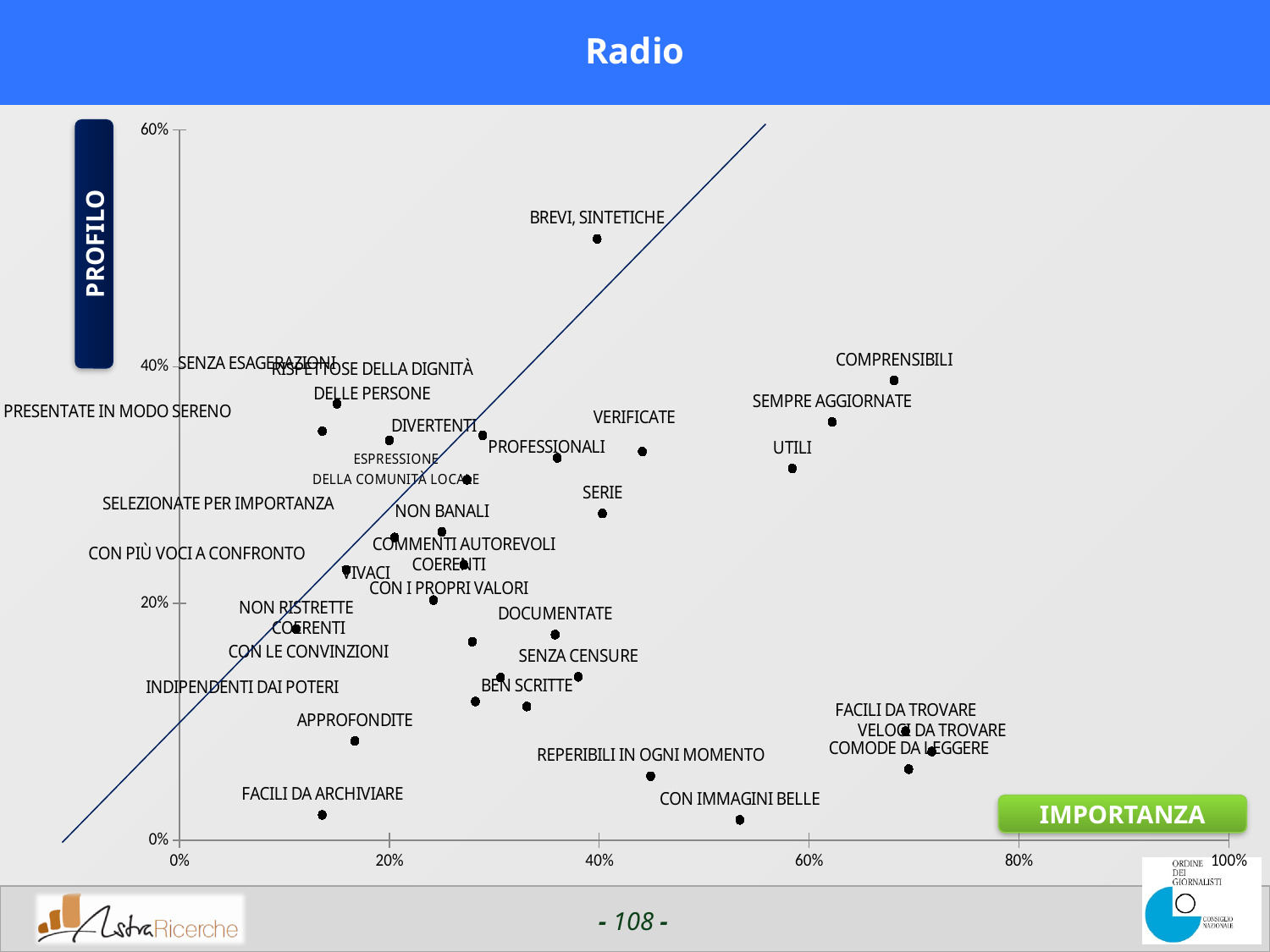
What kind of chart is shown on the slide? scatter chart Is the PROFILO value for APPROFONDITE greater or less than 20%? less Which has the higher IMPORTANZA value, COMPRENSIBILI or FACILI DA ARCHIVIARE? COMPRENSIBILI Is the IMPORTANZA value for FACILI DA ARCHIVIARE greater or less than 20%? less Is the PROFILO value for CON IMMAGINI BELLE greater or less than 20%? less What is the title of the chart? Radio Which point has the highest PROFILO value? BREVI, SINTETICHE What label is given to the horizontal axis of the chart? IMPORTANZA Which has the higher PROFILO value, BREVI, SINTETICHE or COMPRENSIBILI? BREVI, SINTETICHE